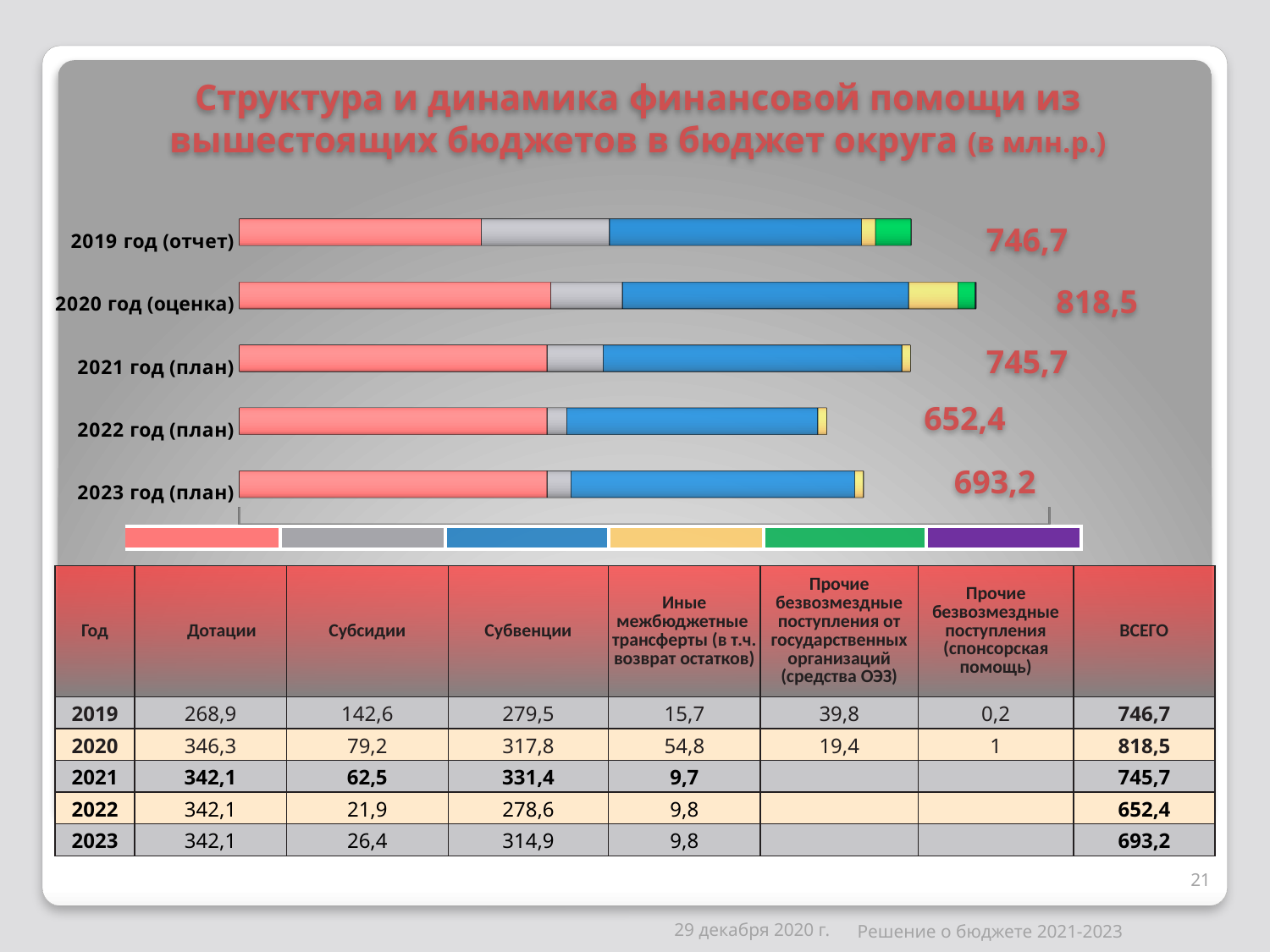
What type of chart is shown on the slide? stacked bar chart What is the total value labelled for 2019 год (отчет)? 746,7 Which total is larger, 2022 год (план) or 2023 год (план)? 2023 год (план) How many colour entries does the chart legend show? 6 What is the difference between the totals for 2020 год (оценка) and 2019 год (отчет)? 71,8 Which year has the highest total in the chart? 2020 год (оценка) How many years (categories) are plotted in the chart? 5 What is the total value labelled for 2021 год (план)? 745,7 Which year has the lowest total in the chart? 2022 год (план) What is the total value labelled for 2023 год (план)? 693,2 What is the difference between the totals for 2023 год (план) and 2022 год (план)? 40,8 Do the totals rise or fall from 2020 год (оценка) to 2022 год (план)? fall